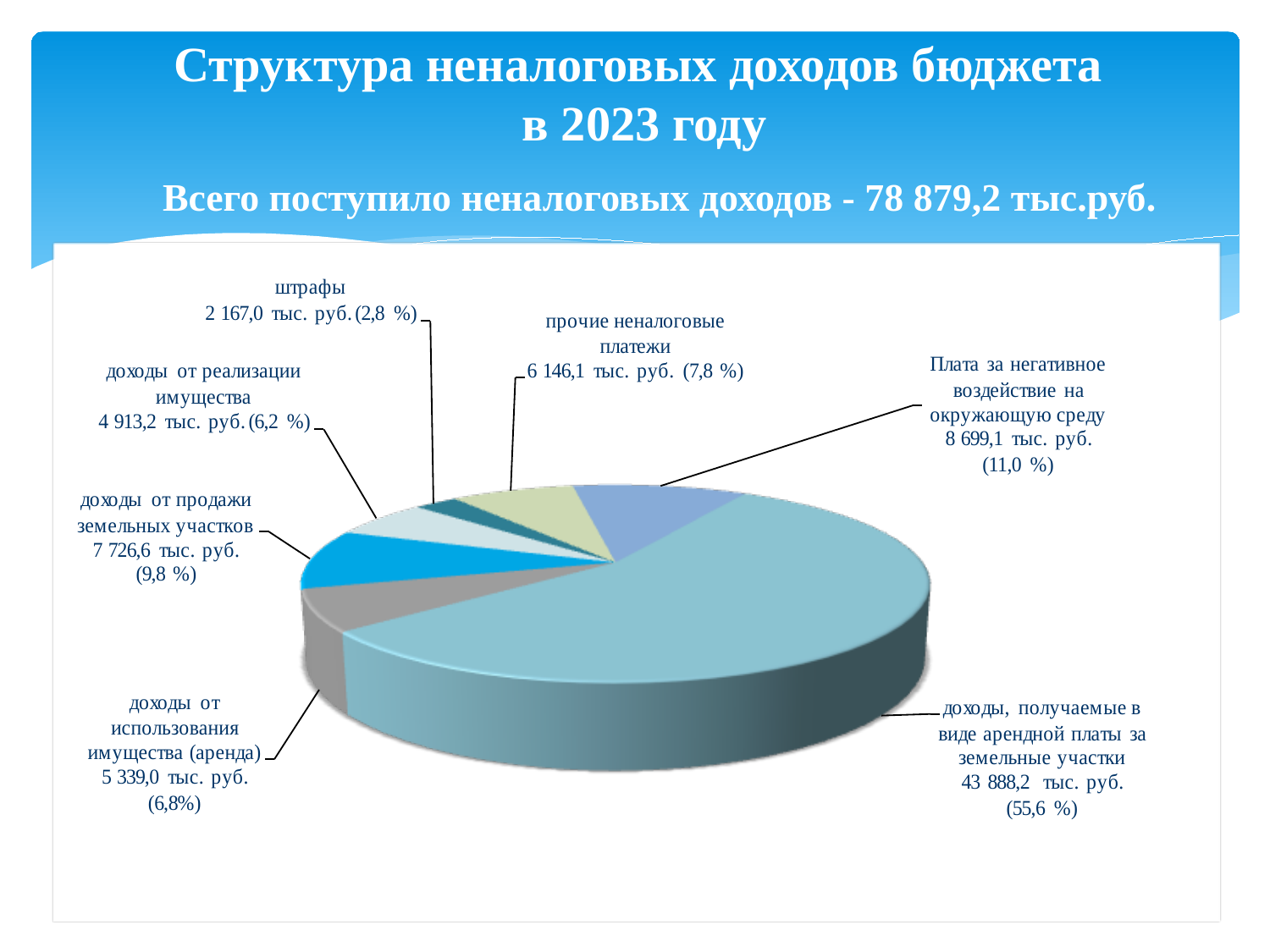
What is the title of the slide? Структура неналоговых доходов бюджета в 2023 году What is the value for «штрафы»? 2 167,0 тыс. руб. What kind of chart is shown on the slide? pie chart What is the value for «доходы от продажи земельных участков»? 7 726,6 тыс. руб. Which category has the smallest slice of the pie? штрафы What is the difference in value between «Плата за негативное воздействие на окружающую среду» and «доходы от продажи земельных участков»? 972,5 тыс. руб. What is the total of non-tax revenues stated on the slide? 78 879,2 тыс.руб. What share of the pie is «доходы от использования имущества (аренда)»? 6,8% What share of the pie is «Плата за негативное воздействие на окружающую среду»? 11,0 % How many slices does the pie chart have? 7 Which is larger: «прочие неналоговые платежи» or «доходы от реализации имущества»? прочие неналоговые платежи Which category has the largest slice of the pie? доходы, получаемые в виде арендной платы за земельные участки